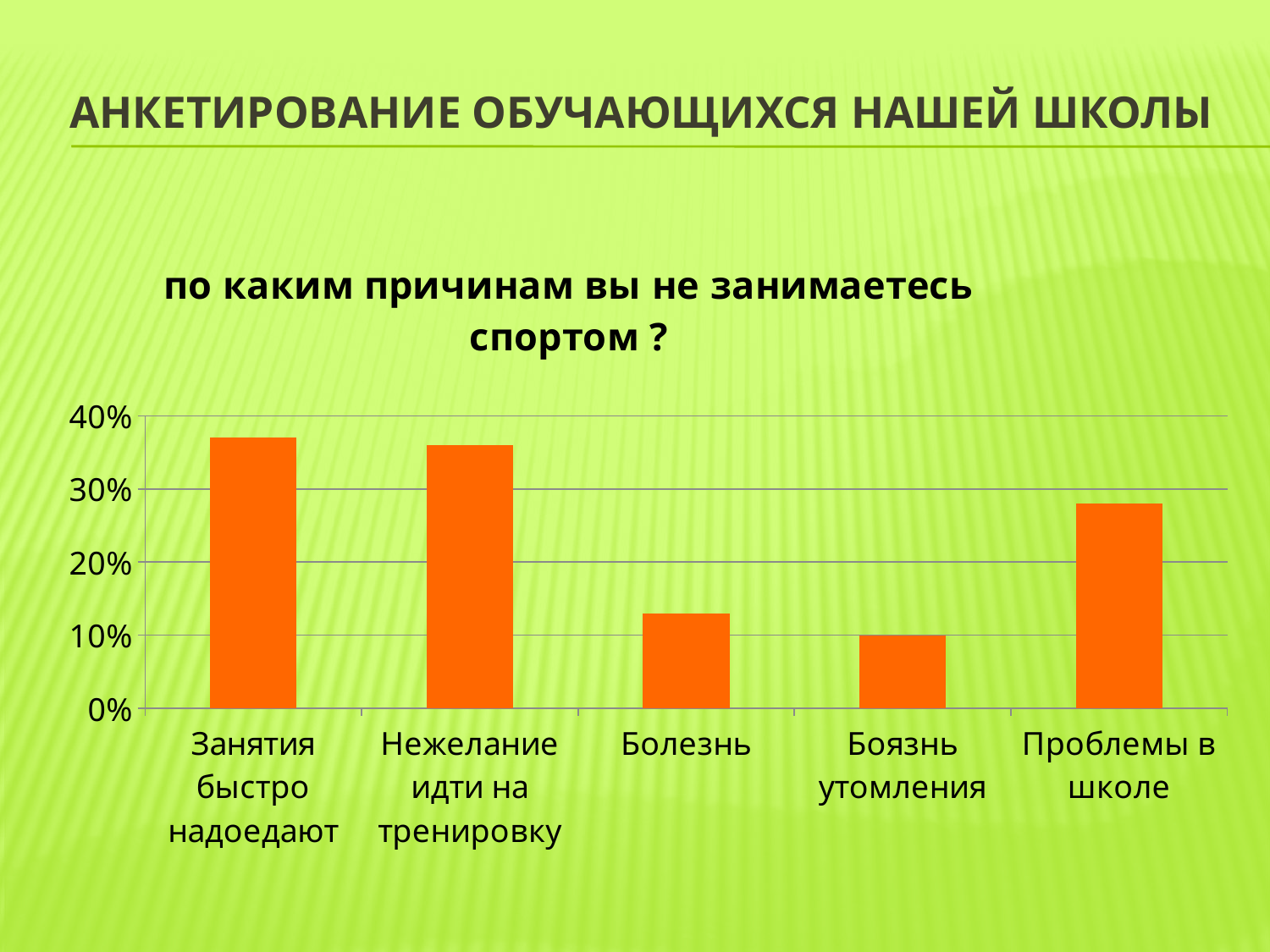
Is the value for Занятия быстро надоедают greater or less than 30%? greater What is the title of the chart? по каким причинам вы не занимаетесь спортом ? How many categories (reasons) are shown on the chart? 5 Which is larger: the value for Проблемы в школе or the value for Болезнь? Проблемы в школе Is the value for Нежелание идти на тренировку greater or less than 30%? greater What kind of chart is shown on the slide? bar chart Is the value for Болезнь greater or less than 10%? greater What colour are the bars in the chart? orange Which category has the lowest value? Боязнь утомления Which is larger: the value for Занятия быстро надоедают or the value for Проблемы в школе? Занятия быстро надоедают